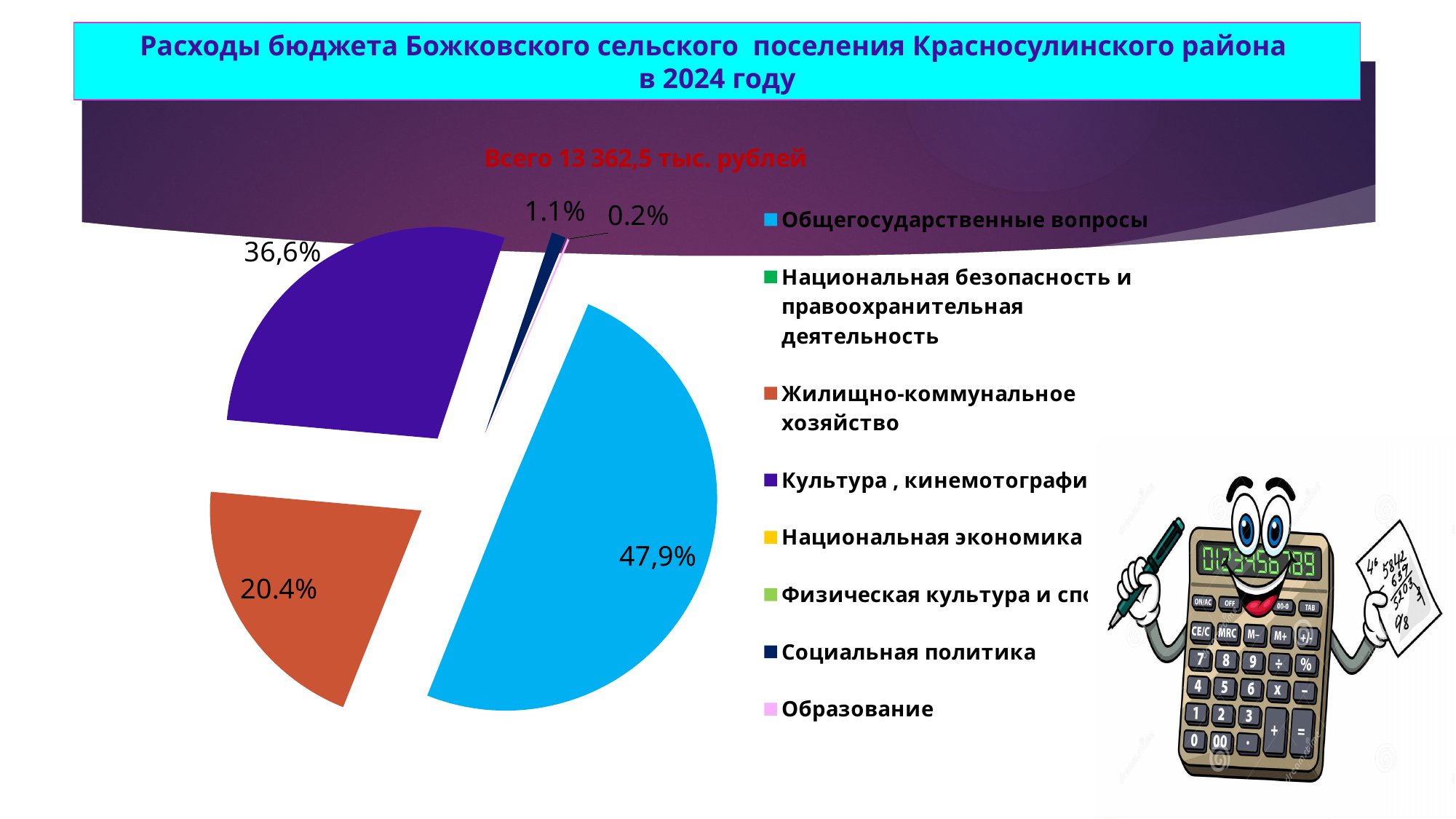
Which slice is larger: Культура, кинемотография or Жилищно-коммунальное хозяйство? Культура, кинемотография Which category has the largest slice of the pie? Общегосударственные вопросы How many entries does the legend list? 8 What share of the pie is labelled for Общегосударственные вопросы? 47,9% What share of the pie is labelled for Социальная политика? 1.1% What share of the pie is labelled for Культура, кинемотография? 36,6% What total amount of expenditure is stated above the pie chart? 13 362,5 тыс. рублей Which labelled slice is the smallest in the pie? Образование What share of the pie is labelled for Образование? 0.2% What share of the pie is labelled for Жилищно-коммунальное хозяйство? 20.4% What colour is the slice for Общегосударственные вопросы? blue What kind of chart is shown on the slide? pie chart